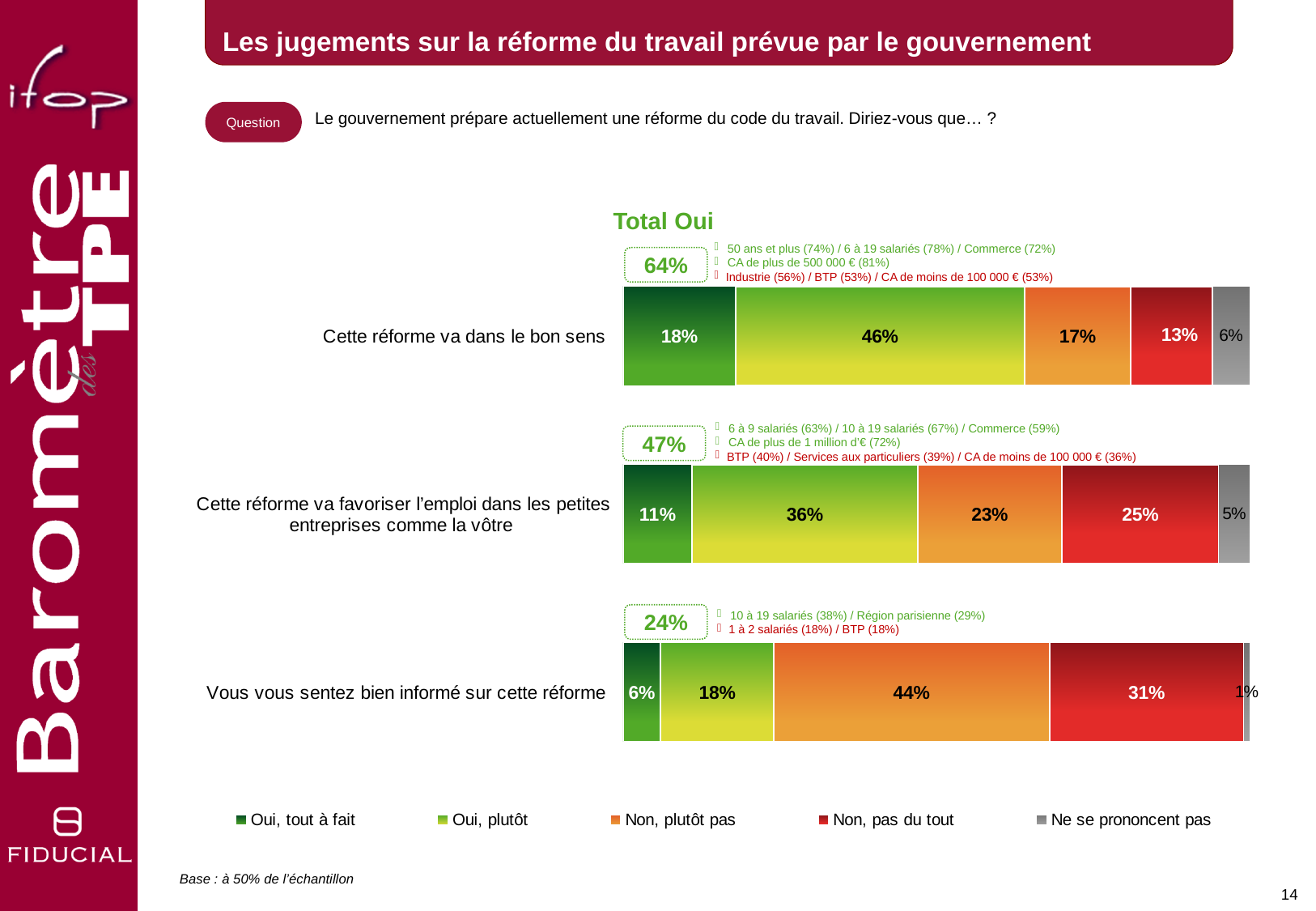
What percentage of respondents answered "Oui, plutôt" to "Cette réforme va dans le bon sens"? 46% How many statements (bars) are shown in the chart? 3 What kind of chart is shown on the slide? Stacked bar chart Which statement has the lowest "Oui, tout à fait" share? Vous vous sentez bien informé sur cette réforme What is the combined share of "Non, plutôt pas" and "Non, pas du tout" for "Vous vous sentez bien informé sur cette réforme"? 75% Which is larger: the "Non, plutôt pas" share for "Cette réforme va dans le bon sens" or for "Cette réforme va favoriser l'emploi dans les petites entreprises comme la vôtre"? Cette réforme va favoriser l'emploi dans les petites entreprises comme la vôtre What is the "Total Oui" value for "Cette réforme va favoriser l'emploi dans les petites entreprises comme la vôtre"? 47% What percentage answered "Non, pas du tout" to "Cette réforme va favoriser l'emploi dans les petites entreprises comme la vôtre"? 25% How many response categories does the legend list? 5 What percentage answered "Non, plutôt pas" to "Vous vous sentez bien informé sur cette réforme"? 44% What is the difference between the "Oui, plutôt" shares for "Cette réforme va dans le bon sens" and "Vous vous sentez bien informé sur cette réforme"? 28 percentage points Which statement has the highest "Total Oui" value? Cette réforme va dans le bon sens